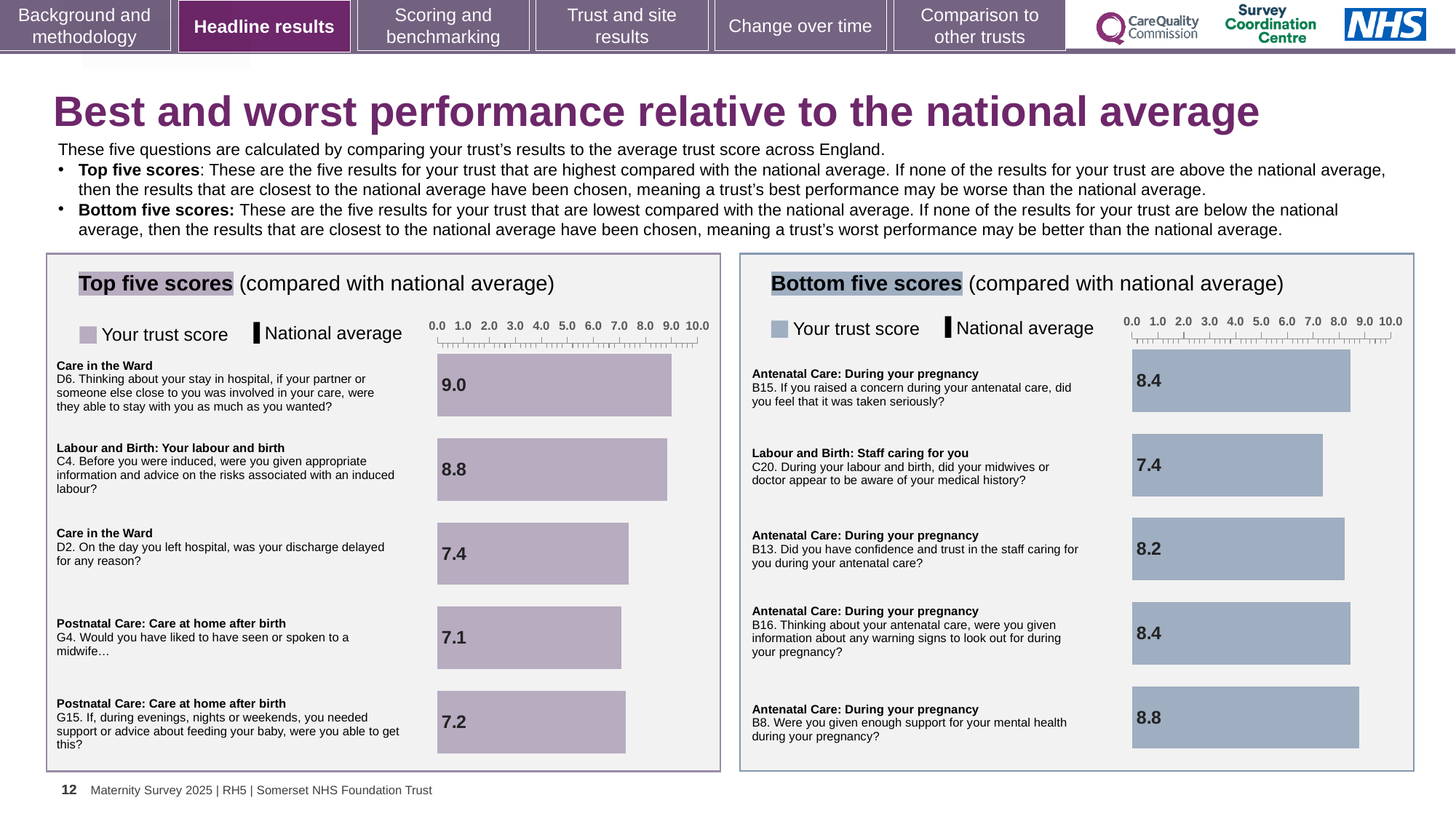
What two entries does the legend of the Top five scores chart list? Your trust score and National average In the Bottom five scores chart, what is the trust score for C20 (midwives or doctor aware of your medical history)? 7.4 In the Top five scores chart, which question has the lowest trust score? G4 (Postnatal Care: Care at home after birth) How many questions are shown in the Top five scores chart? 5 What type of chart is used for the Bottom five scores? Bar chart In the Bottom five scores chart, which question has the highest trust score? B8 (Antenatal Care: During your pregnancy) In the Top five scores chart, which question has the highest trust score? D6 (Care in the Ward) In the Bottom five scores chart, which question has the lowest trust score? C20 (Labour and Birth: Staff caring for you) In the Bottom five scores chart, which has the larger trust score, B15 or B13? B15 In the Top five scores chart, what is the difference between the trust scores for D6 and G4? 1.9 In the Top five scores chart, is the trust score for C4 greater or less than 8.0? greater In the Top five scores chart, what is the trust score for D6 (partner or someone close able to stay with you as much as you wanted)? 9.0